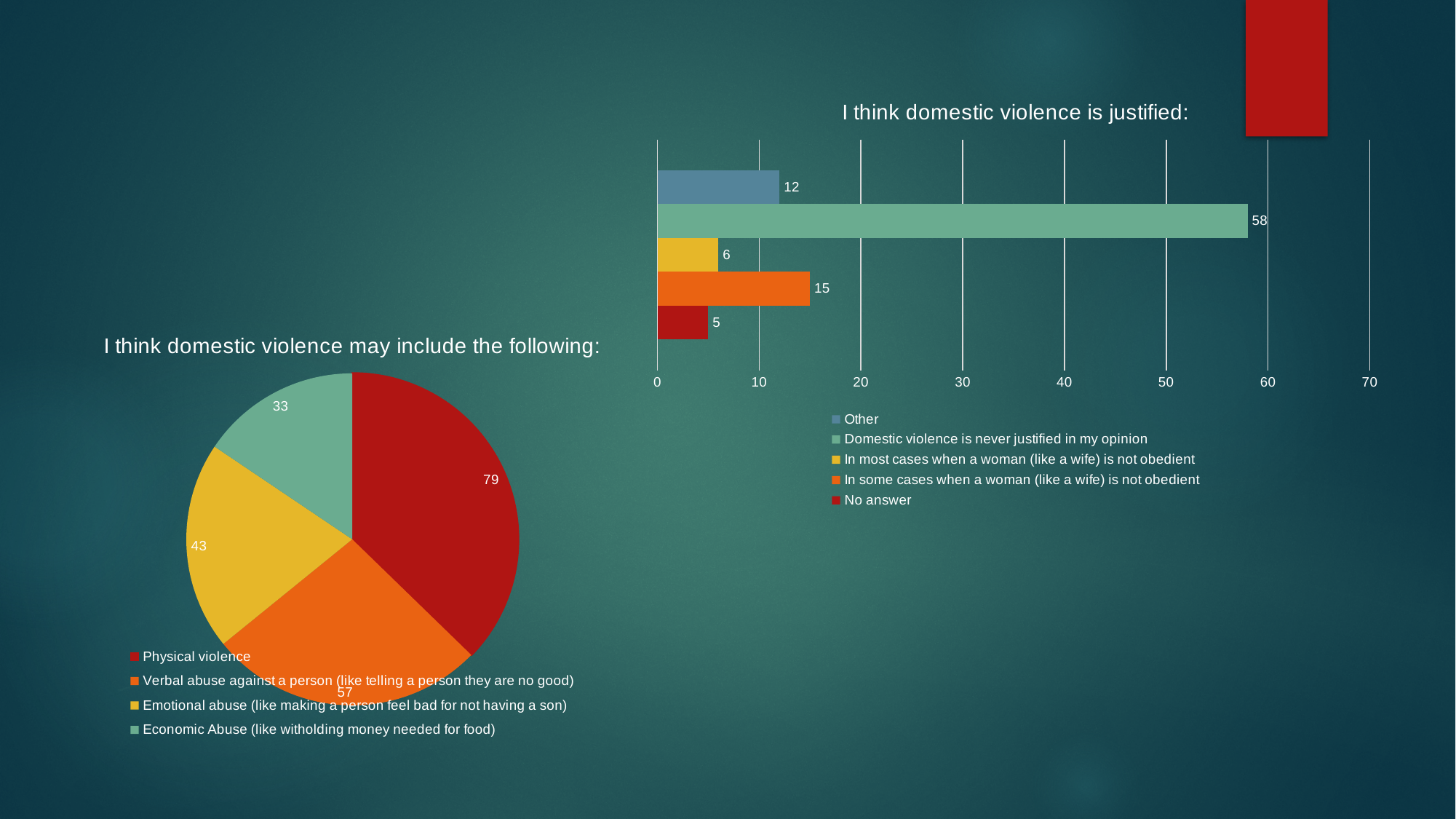
In the pie chart titled "I think domestic violence may include the following:", which is larger: "Verbal abuse against a person (like telling a person they are no good)" or "Emotional abuse (like making a person feel bad for not having a son)"? Verbal abuse against a person (like telling a person they are no good) In the chart titled "I think domestic violence is justified:", what is the difference between "In some cases when a woman (like a wife) is not obedient" and "In most cases when a woman (like a wife) is not obedient"? 9 In the pie chart titled "I think domestic violence may include the following:", what colour is the "Physical violence" slice? Red In the pie chart titled "I think domestic violence may include the following:", what is the difference between "Physical violence" and "Economic Abuse (like witholding money needed for food)"? 46 In the pie chart titled "I think domestic violence may include the following:", what is the value for "Physical violence"? 79 In the chart titled "I think domestic violence is justified:", how many categories are shown? 5 In the chart titled "I think domestic violence is justified:", which category has the lowest value? No answer In the chart titled "I think domestic violence is justified:", which category has the highest value? Domestic violence is never justified in my opinion In the chart titled "I think domestic violence is justified:", what is the value for "Domestic violence is never justified in my opinion"? 58 In the pie chart titled "I think domestic violence may include the following:", which category has the smallest slice? Economic Abuse (like witholding money needed for food) In the chart titled "I think domestic violence is justified:", what is the value for "Other"? 12 What kind of chart is the one titled "I think domestic violence is justified:"? Bar chart